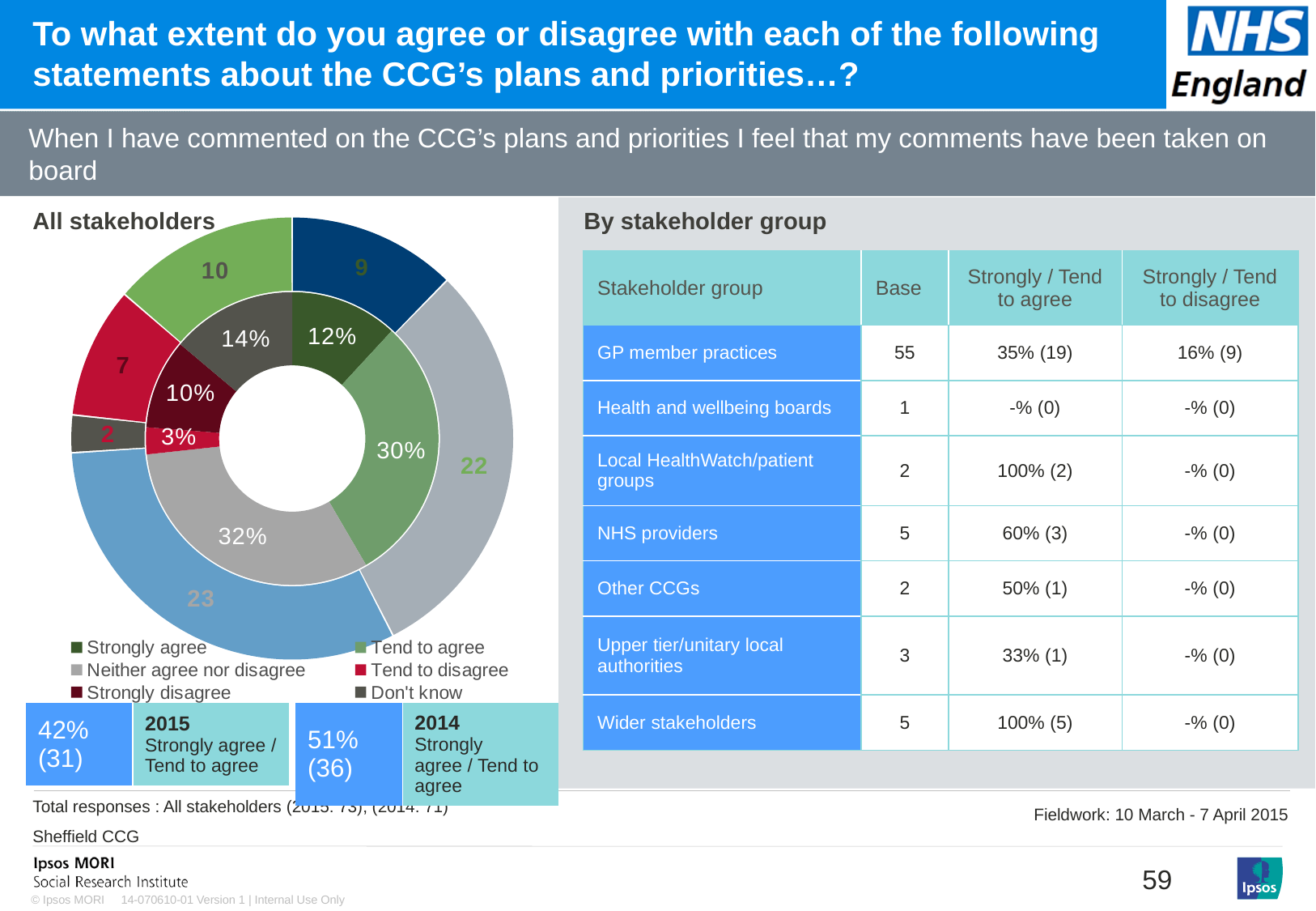
Which response category has the smallest share in the 'All stakeholders' chart? Tend to disagree In the 'All stakeholders' chart, what percentage of respondents neither agree nor disagree? 32% In the 'All stakeholders' chart, which is larger: the share for 'Don't know' or for 'Strongly disagree'? Don't know In the 'All stakeholders' chart, how many percentage points higher is 'Tend to agree' than 'Strongly agree'? 18 percentage points In the 'All stakeholders' chart, what percentage strongly agree? 12% According to the box below the 'All stakeholders' chart, what percentage of stakeholders strongly agreed or tended to agree in 2015? 42% In the 'All stakeholders' chart, what is the difference in percentage points between 'Neither agree nor disagree' and 'Tend to agree'? 2 percentage points What type of chart is used to show the 'All stakeholders' results? Doughnut (pie) chart How many response categories does the legend of the 'All stakeholders' chart list? 6 In the 'All stakeholders' chart, what percentage answered 'Don't know'? 14% Which response category has the largest share in the 'All stakeholders' chart? Neither agree nor disagree In the 'All stakeholders' chart, what percentage tend to disagree? 3%